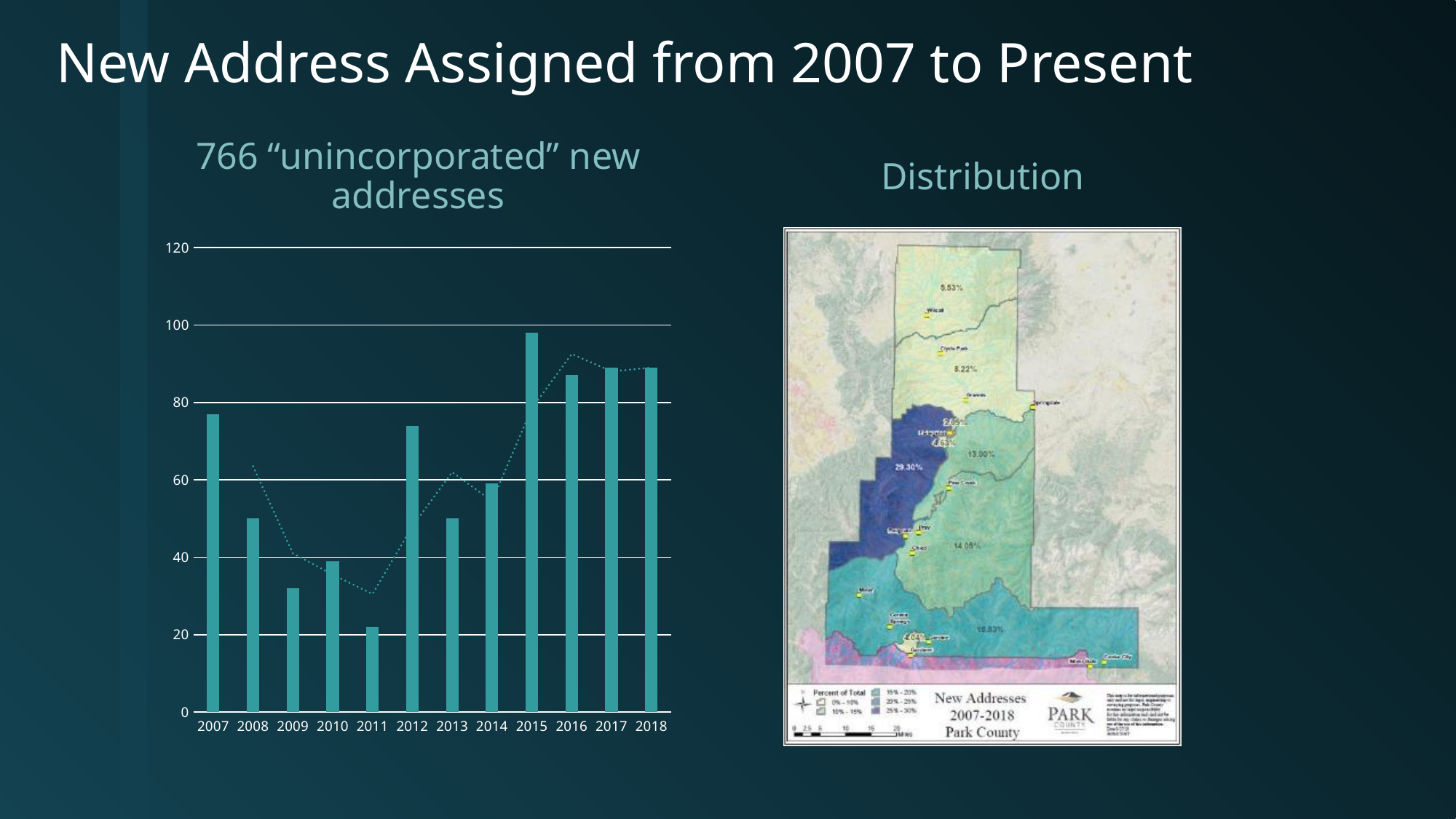
What kind of chart is shown on the left of the slide? bar chart In the bar chart, which year has the larger value, 2007 or 2008? 2007 In the bar chart, which year has the lowest number of new addresses? 2011 In the bar chart, is the value for 2007 greater or less than 60? greater In the bar chart, is the value for 2015 greater or less than 80? greater How many years are shown on the x axis of the bar chart? 12 What is the title of the bar chart on the left? 766 "unincorporated" new addresses In the bar chart, which year has the highest number of new addresses? 2015 In the bar chart, which year has the larger value, 2012 or 2014? 2012 In the bar chart, is the value for 2011 greater or less than 40? less In the bar chart, do the values rise or fall from 2013 to 2015? rise